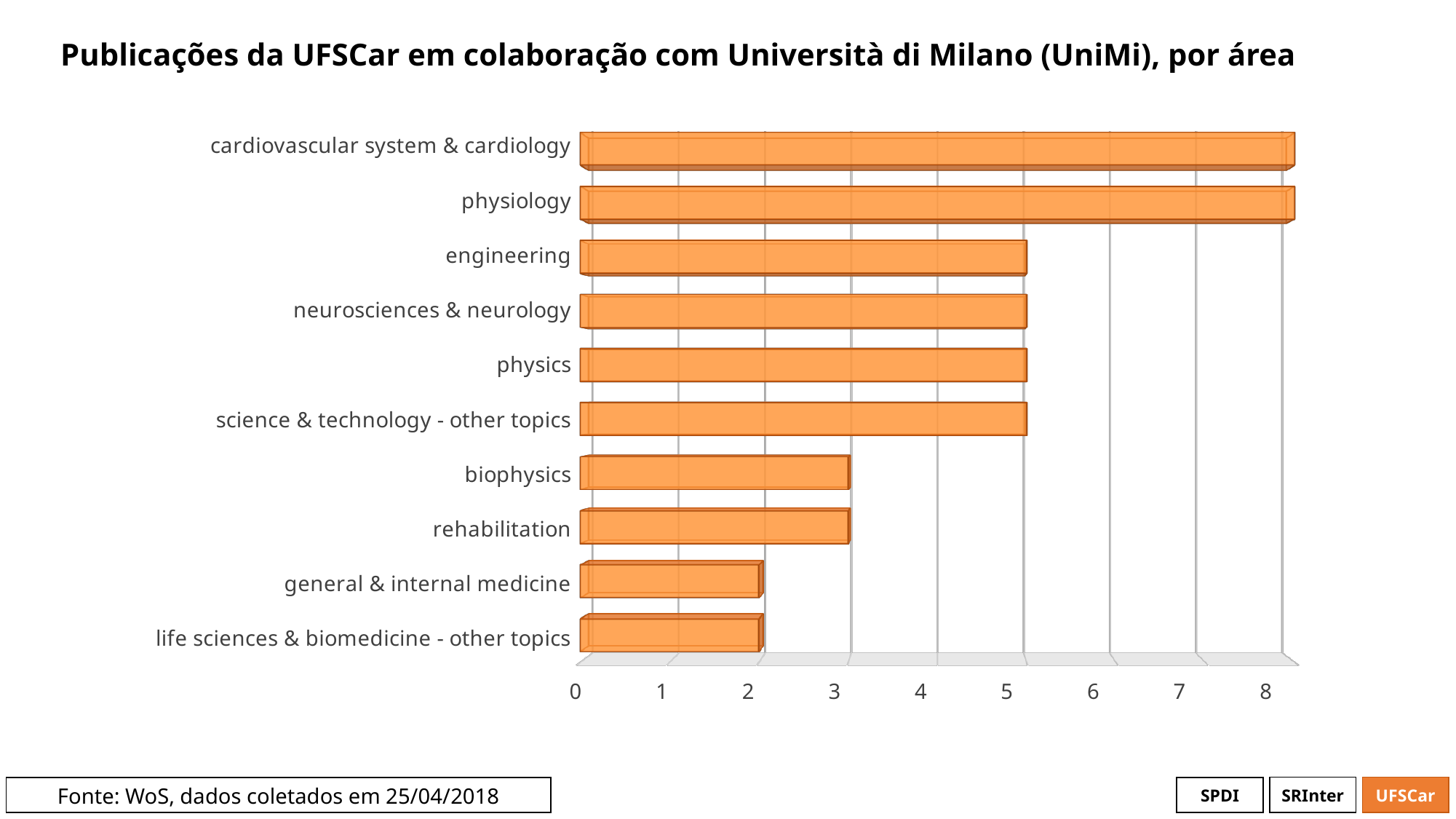
What kind of chart is shown on the slide? bar chart Is the value for rehabilitation greater or less than 4? less What is the title of the chart? Publicações da UFSCar em colaboração com Università di Milano (UniMi), por área What is the value for engineering? 5 What is the value for cardiovascular system & cardiology? 8 Which has a larger value, engineering or biophysics? engineering Is the value for physiology greater or less than 7? greater Which has a larger value, life sciences & biomedicine - other topics or physics? physics How many areas (categories) are shown in the chart? 10 What is the value for biophysics? 3 What is the difference between the values for cardiovascular system & cardiology and biophysics? 5 What is the value for general & internal medicine? 2